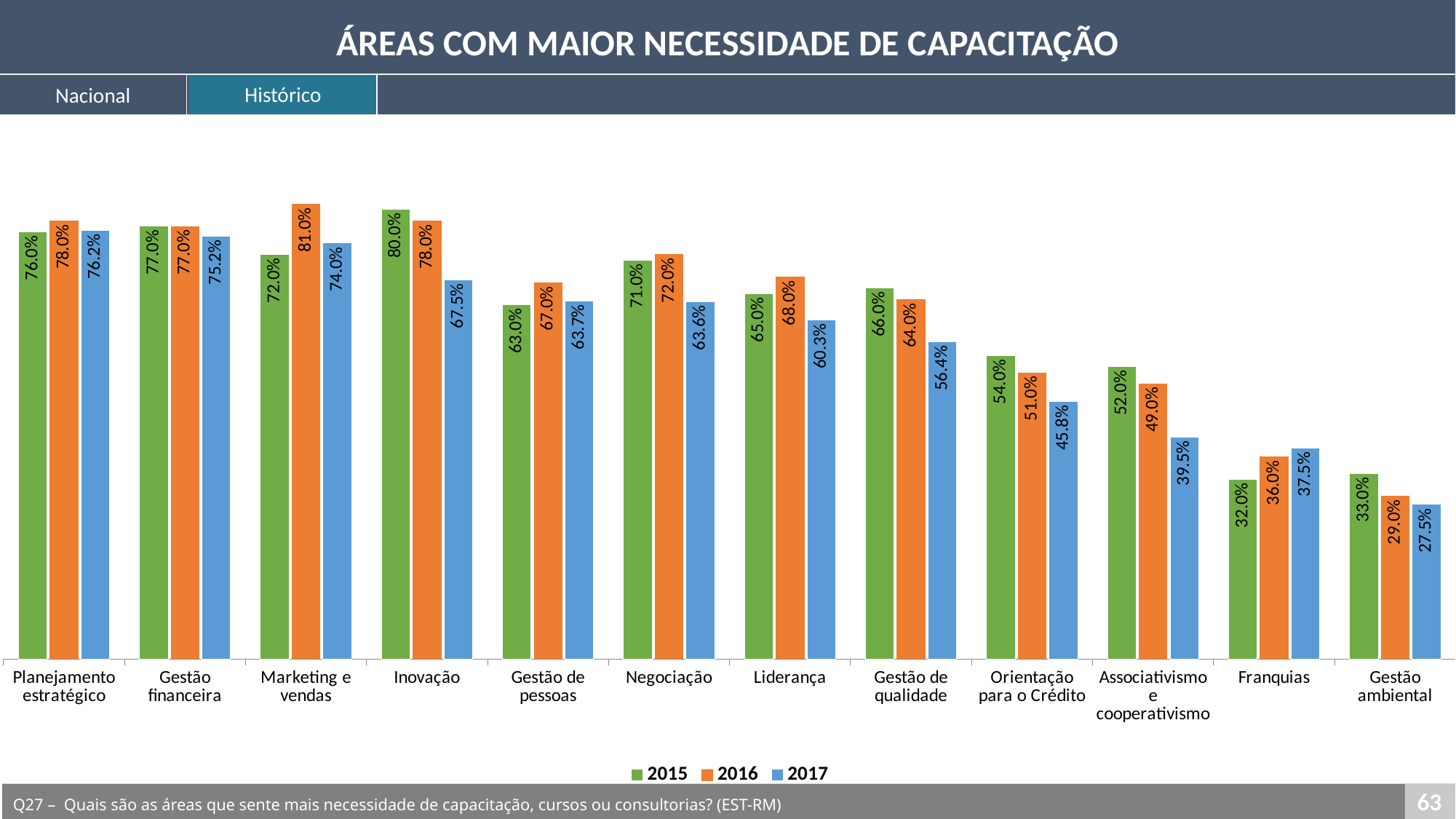
Do the 2017 values for Franquias rise or fall compared with 2015 and 2016? Rise What is the value for Associativismo e cooperativismo in 2017? 39.5% How many series does the legend list? 3 Which category has the lowest value in the 2017 series? Gestão ambiental What is the difference between the 2016 and 2017 values for Inovação? 10.5% What is the value for Inovação in 2015? 80.0% What is the value for Franquias in 2016? 36.0% How many categories are shown on the x axis? 12 What is the difference between the 2015 and 2017 values for Gestão de qualidade? 9.6% What kind of chart is shown on the slide? Bar chart Which category has the highest value in the 2016 series? Marketing e vendas Which is larger for Liderança: the 2016 value or the 2017 value? 2016